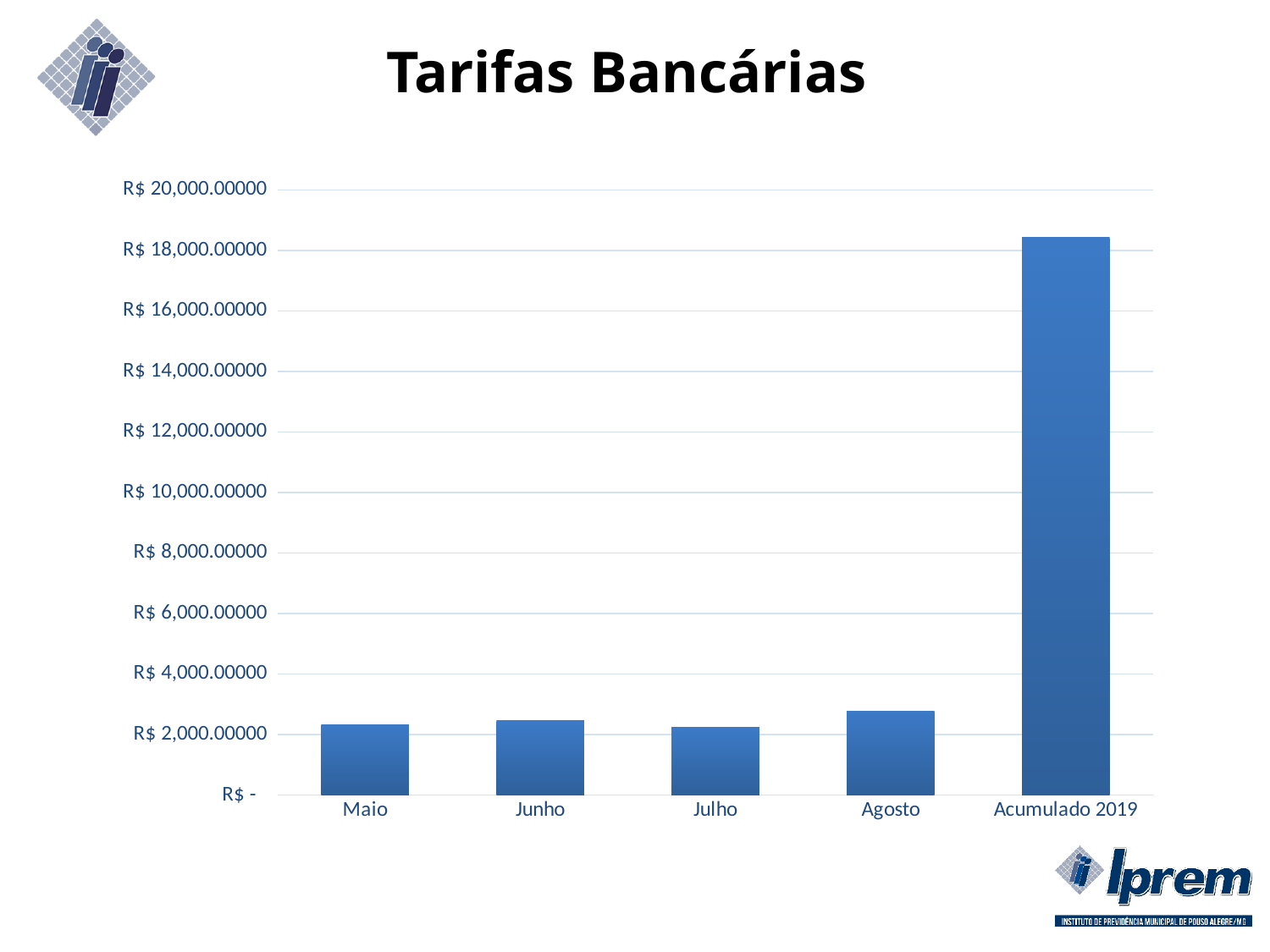
What is the title of the chart? Tarifas Bancárias Which is larger, the value for Agosto or the value for Julho? Agosto Which is larger, the value for Agosto or the value for Maio? Agosto How many categories are shown on the x axis of the chart? 5 Is the value for Maio greater or less than R$ 4,000.00000? less Is the value for Agosto greater or less than R$ 2,000.00000? greater What kind of chart is shown on the slide? bar chart Among the monthly categories (Maio, Junho, Julho, Agosto), which has the highest value? Agosto Which category has the highest value in the chart? Acumulado 2019 Is the value for Julho greater or less than R$ 4,000.00000? less